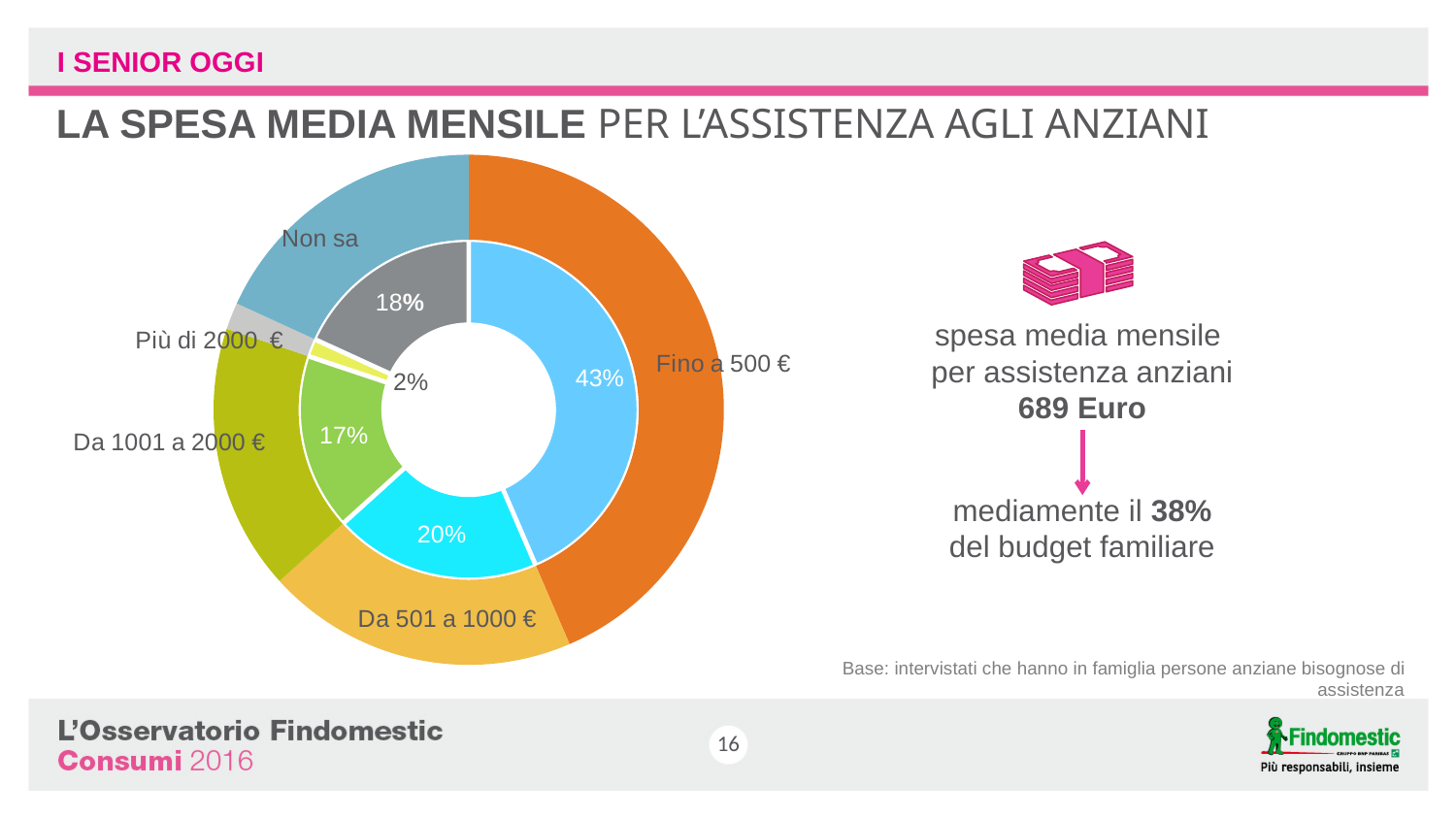
What percentage is shown for the 'Da 1001 a 2000 €' category? 17% What percentage is shown for the 'Più di 2000 €' category? 2% What kind of chart is shown on the slide? Doughnut (pie) chart What is the average monthly spending for elderly care stated on the slide? 689 Euro What percentage of respondents answered 'Non sa'? 18% Which category has the smallest share in the chart? Più di 2000 € Which category has the largest share in the chart? Fino a 500 € What share of respondents spend 'Fino a 500 €' per month on elderly care? 43% What is the difference in percentage points between 'Fino a 500 €' and 'Da 501 a 1000 €'? 23 How many categories are shown in the chart? 5 What percentage is shown for the 'Da 501 a 1000 €' category? 20% Which is larger: the share for 'Non sa' or the share for 'Da 1001 a 2000 €'? Non sa